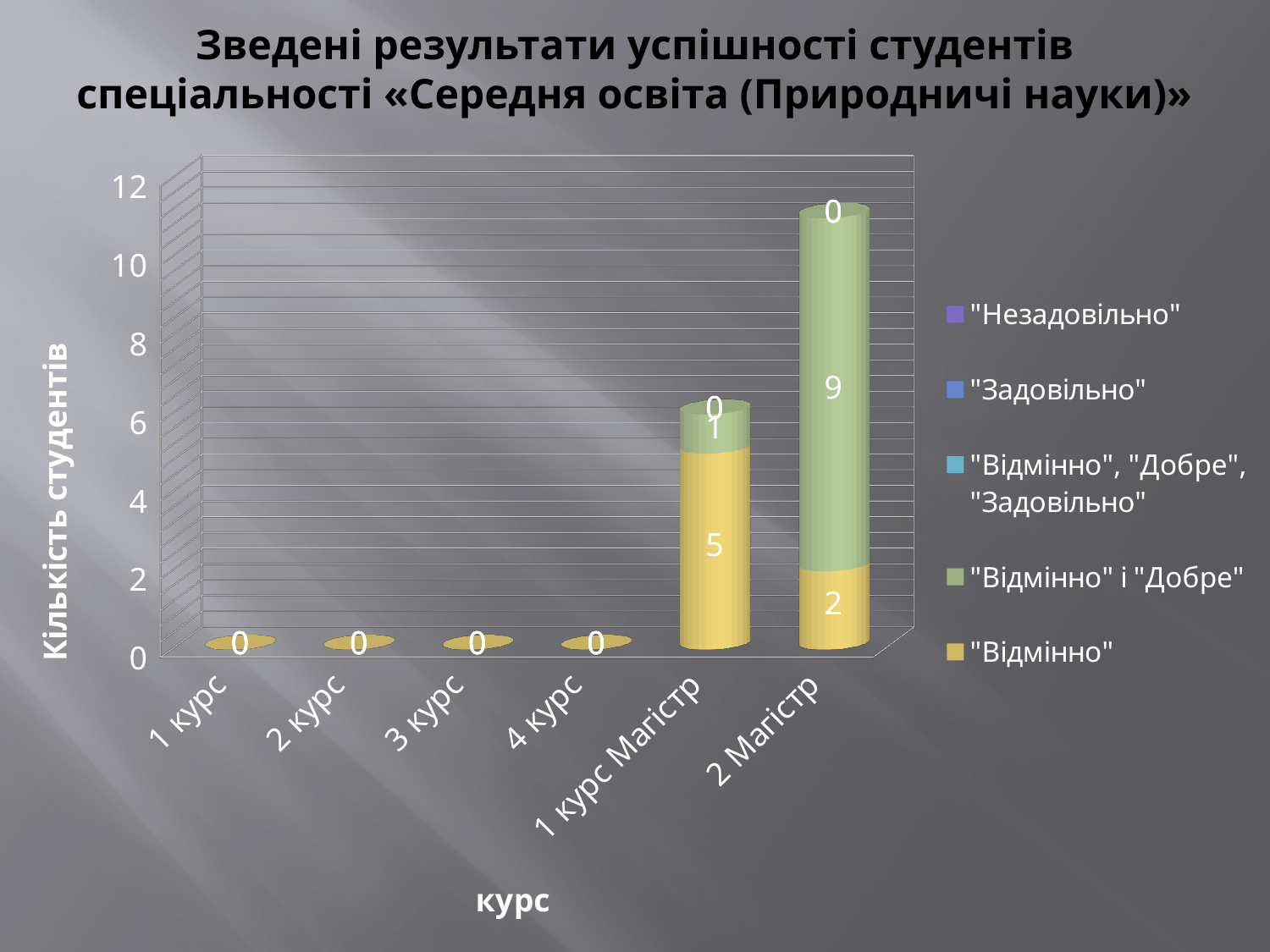
What is the value shown for 3 курс? 0 What is the label of the y axis? Кількість студентів What is the value of "Відмінно" for 1 курс Магістр? 5 How many categories are shown on the x axis of the chart? 6 Which category has the tallest stacked bar? 2 Магістр What is the value of "Відмінно" і "Добре" for 2 Магістр? 9 What is the value of "Відмінно" for 2 Магістр? 2 How many series does the legend list? 5 What is the value of "Відмінно" і "Добре" for 1 курс Магістр? 1 What kind of chart is shown on the slide? bar chart Which is larger: "Відмінно" і "Добре" for 2 Магістр or "Відмінно" for 1 курс Магістр? "Відмінно" і "Добре" for 2 Магістр What is the difference between the "Відмінно" values for 1 курс Магістр and 2 Магістр? 3